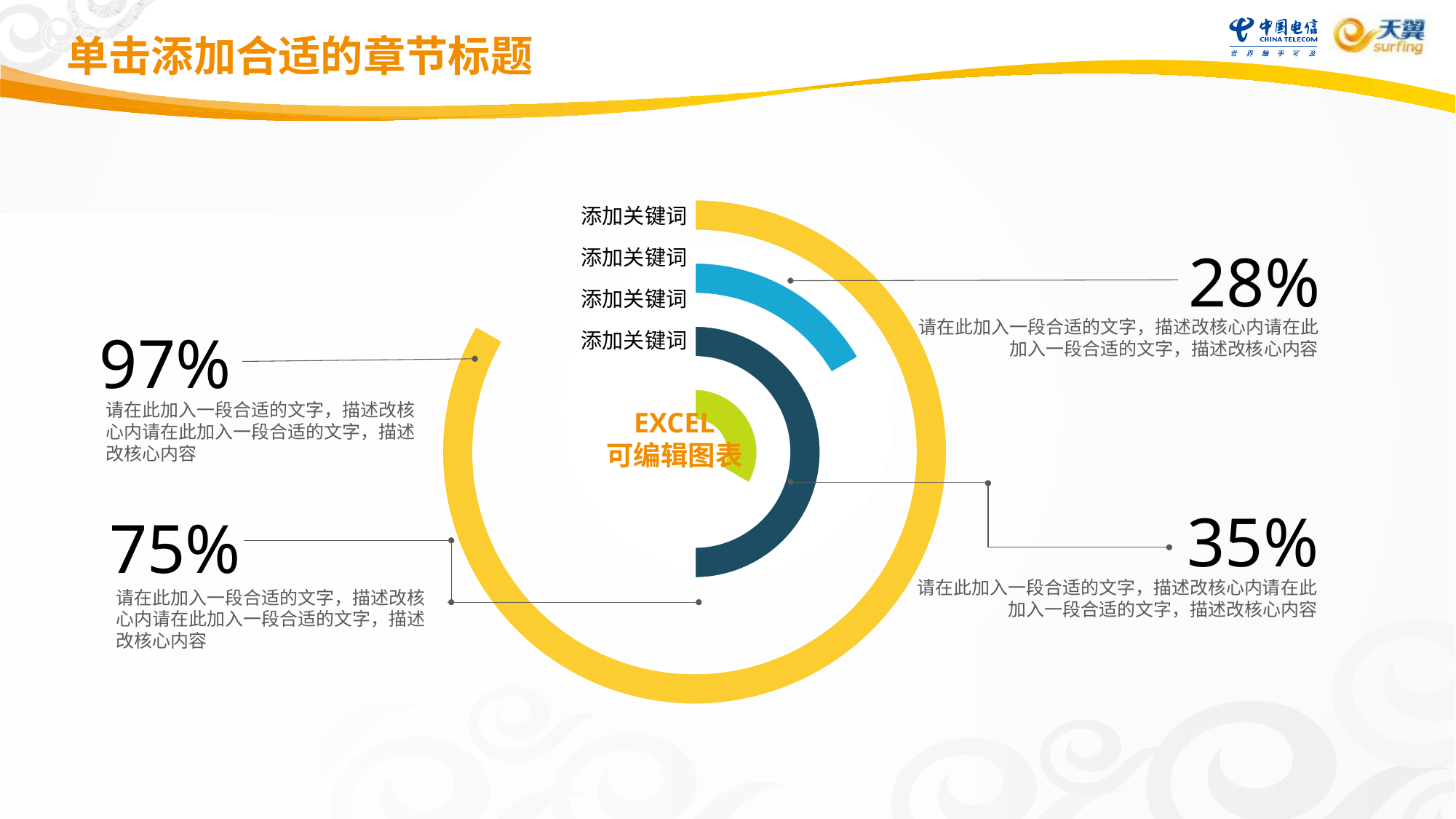
How many rings (data series) does the doughnut chart have? 4 Which is the highest percentage value printed on the slide? 97% Which is the lowest percentage value printed on the slide? 28% What is the difference between the 97% value and the 28% value? 69% What is the colour of the outermost ring of the chart? Yellow Which is larger, the value for the dark blue ring or the value for the light blue ring? Dark blue ring (35%) What kind of chart is shown on the slide? Doughnut chart What is the difference between the 75% value and the 35% value? 40% What percentage is labelled for the dark blue ring of the chart? 35% What percentage is labelled for the outer yellow ring of the chart? 97% What text is printed in the centre of the doughnut chart? EXCEL 可编辑图表 What percentage is labelled for the light blue ring of the chart? 28%